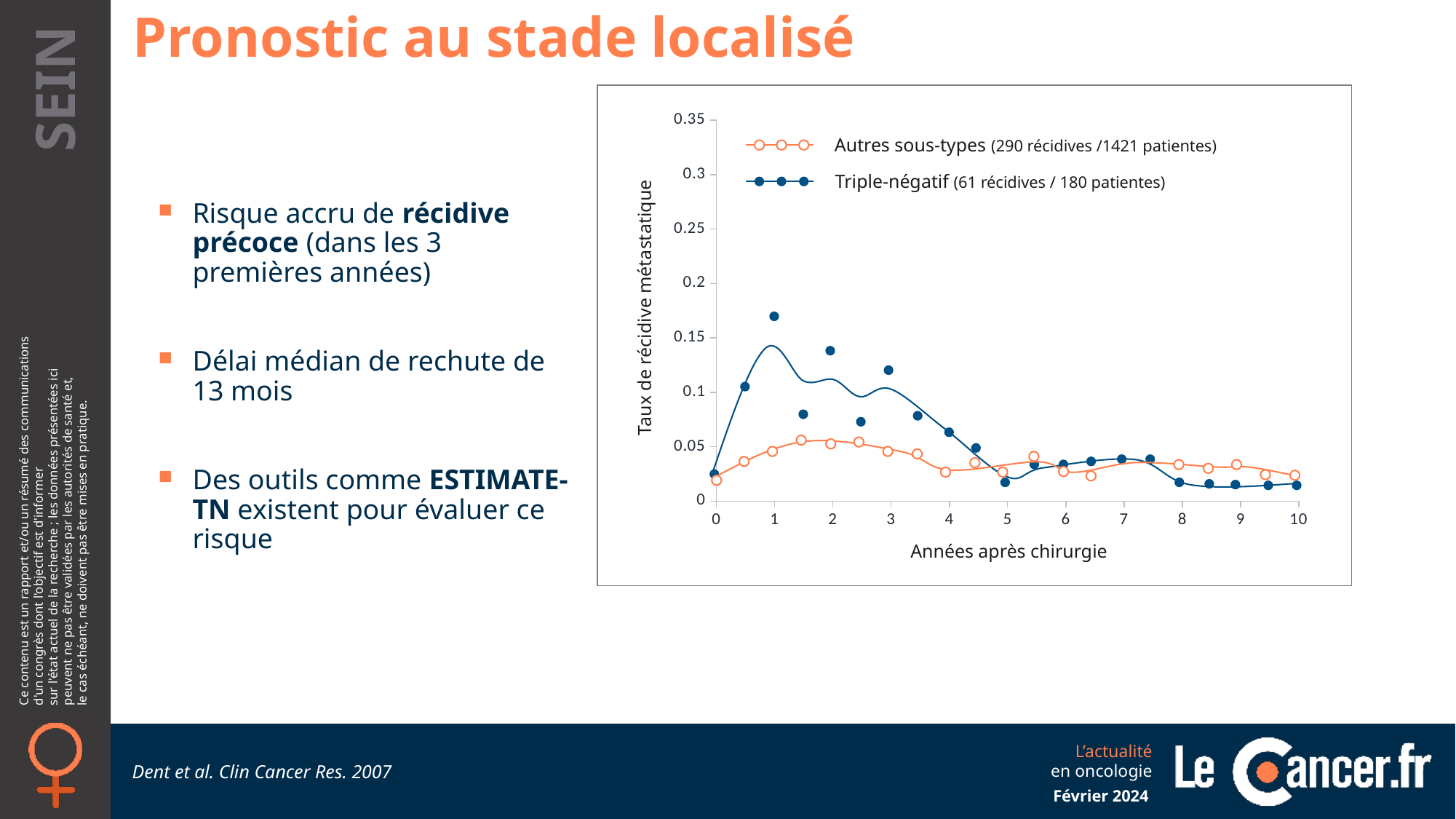
What is the title of the x axis of the chart? Années après chirurgie Is the value for Autres sous-types at year 1 greater or less than 0.1? less Which series reaches the highest value on the chart? Triple-négatif How many series does the chart legend list? 2 What is the title of the y axis of the chart? Taux de récidive métastatique At year 1, which series has the higher value, Triple-négatif or Autres sous-types? Triple-négatif Between year 1 and year 5, does the Triple-négatif series rise or fall? fall Is the value for Triple-négatif at year 1 greater or less than 0.15? greater What kind of chart is shown on the slide? line chart Is the value for Triple-négatif at year 10 greater or less than 0.05? less At year 9, which series has the higher value, Triple-négatif or Autres sous-types? Autres sous-types